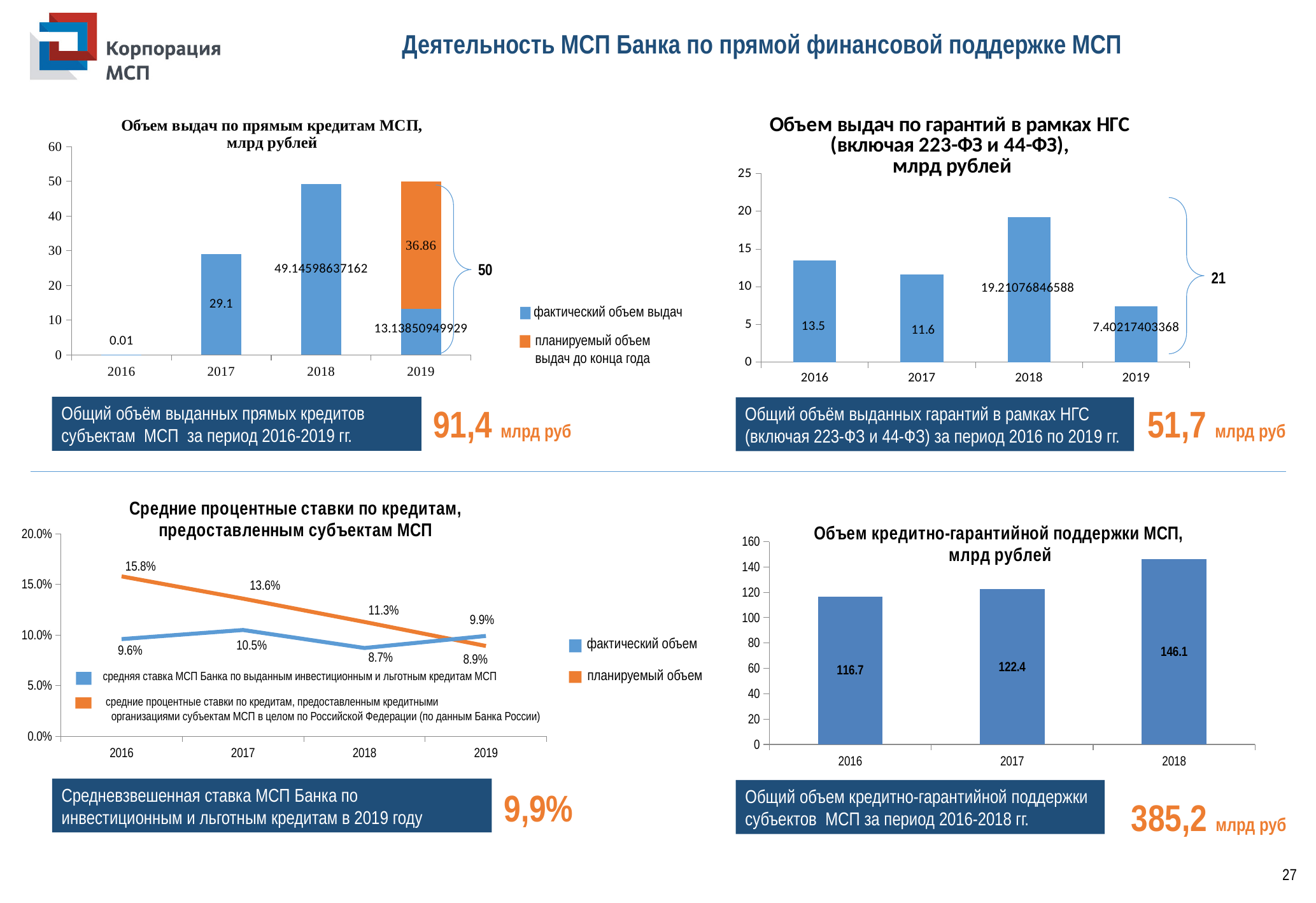
In the chart 'Объем выдач по гарантий в рамках НГС', what is the difference between the 2016 and 2017 values? 1.9 What kind of chart is 'Средние процентные ставки по кредитам, предоставленным субъектам МСП'? Line chart In the chart 'Объем выдач по гарантий в рамках НГС', which year has the highest value? 2018 In the chart 'Объем выдач по прямым кредитам МСП, млрд рублей', what is the total of the stacked bar for 2019? 50 In the chart 'Объем выдач по прямым кредитам МСП, млрд рублей', what is the planned volume (планируемый объем выдач до конца года) for 2019? 36.86 In the chart 'Средние процентные ставки по кредитам, предоставленным субъектам МСП', does the orange series rise or fall from 2016 to 2019? Fall In the chart 'Средние процентные ставки по кредитам, предоставленным субъектам МСП', what is the orange series value for 2016? 15.8% In the chart 'Объем кредитно-гарантийной поддержки МСП, млрд рублей', how many years are shown? 3 How many series does the legend list in the chart 'Объем выдач по прямым кредитам МСП, млрд рублей'? 2 In the chart 'Объем кредитно-гарантийной поддержки МСП, млрд рублей', what is the value for 2018? 146.1 In the chart 'Объем выдач по прямым кредитам МСП, млрд рублей', what is the value for 2017? 29.1 In the chart 'Объем выдач по гарантий в рамках НГС', what is the value for 2017? 11.6